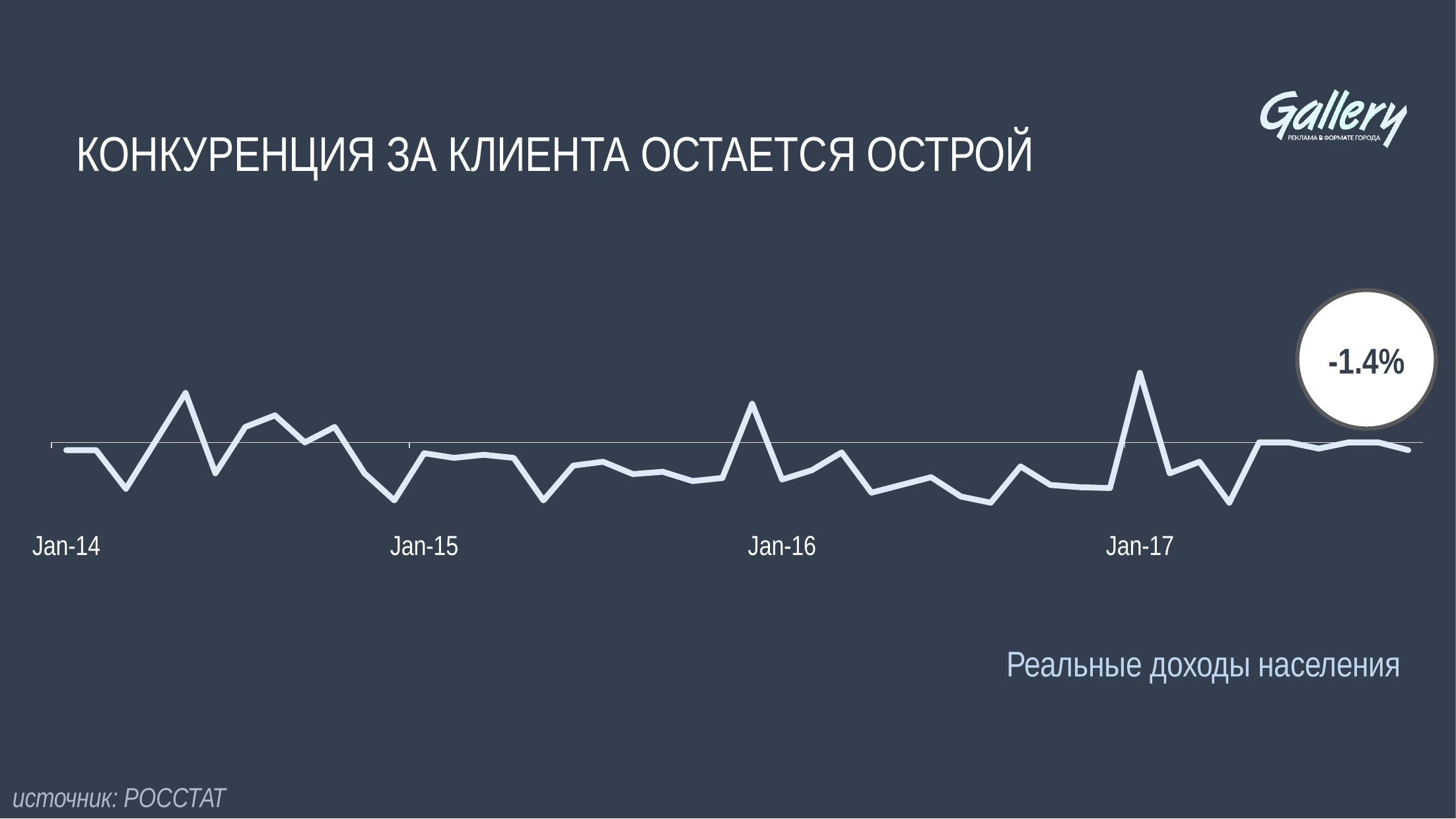
Is the value at Jan-16 greater or less than 0? less Is the value at Jan-17 greater or less than 0? greater Is the value at Jan-14 greater or less than 0? less What value is shown in the circular callout on the chart? -1.4% What is the name of the series plotted on the chart? Реальные доходы населения Which of the labelled x-axis points, Jan-15 or Jan-16, has the higher value? Jan-15 Near which labelled x-axis point does the line reach its highest peak? Jan-17 What kind of chart is shown on the slide? line chart Which of the labelled x-axis points, Jan-16 or Jan-17, has the higher value? Jan-17 How many labelled points are shown on the x axis of the chart? 4